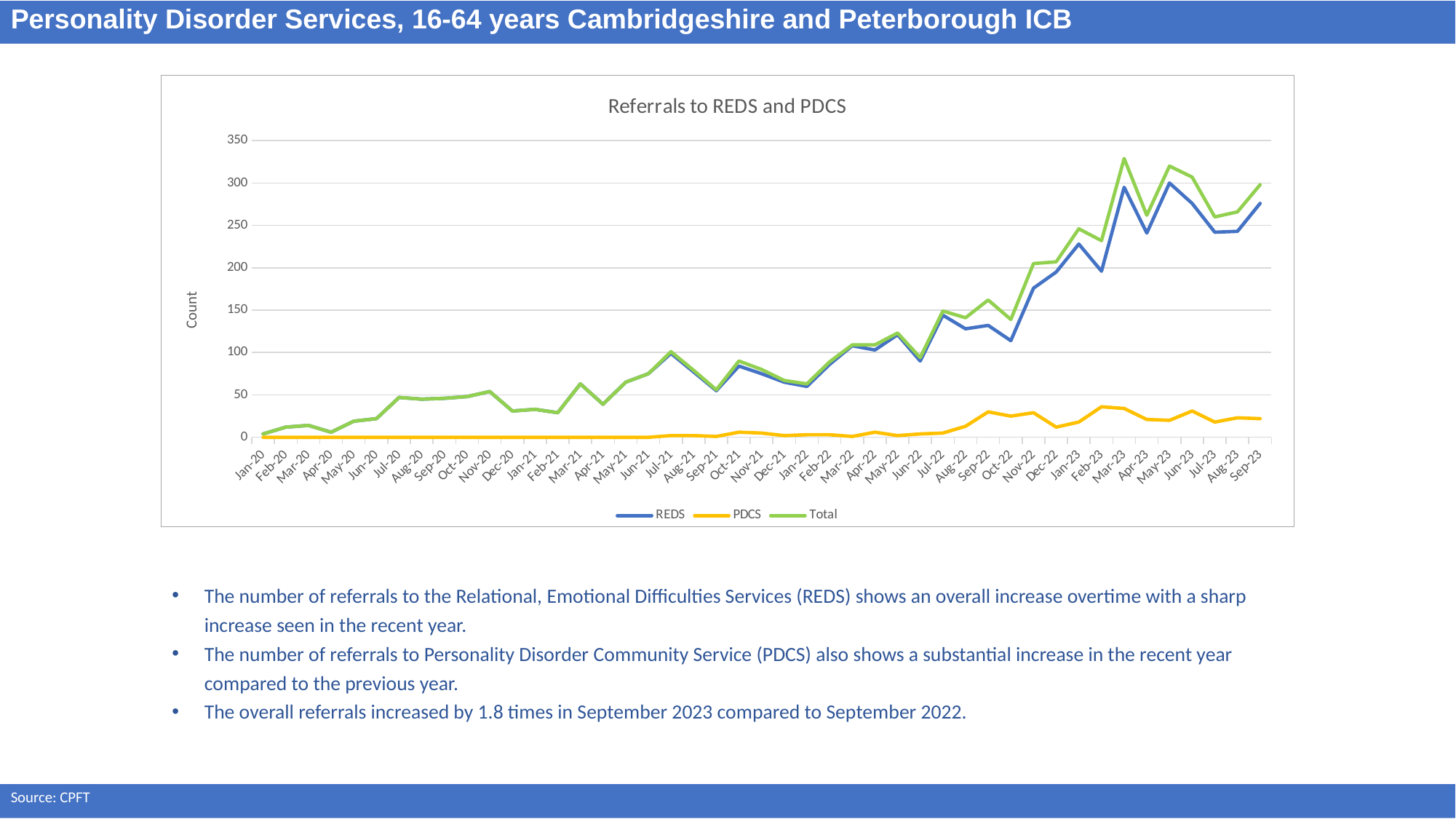
What is the title of the chart? Referrals to REDS and PDCS Which is larger for the Total series, the value in Sep-22 or the value in Sep-23? Sep-23 What is the label on the vertical axis of the chart? Count Is the PDCS value for Feb-23 greater or less than 50? less Is the Total value for Mar-23 greater or less than 300? greater Does the Total series generally rise or fall from Jan-20 to Sep-23? Rise What kind of chart is shown on the slide? Line chart Which is larger in Sep-23, the REDS value or the PDCS value? REDS How many monthly points are plotted along the x axis, from Jan-20 to Sep-23? 45 How many series does the legend of the chart list? 3 In which month does the Total series reach its highest value? Mar-23 Is the REDS value for Sep-23 greater or less than 250? greater